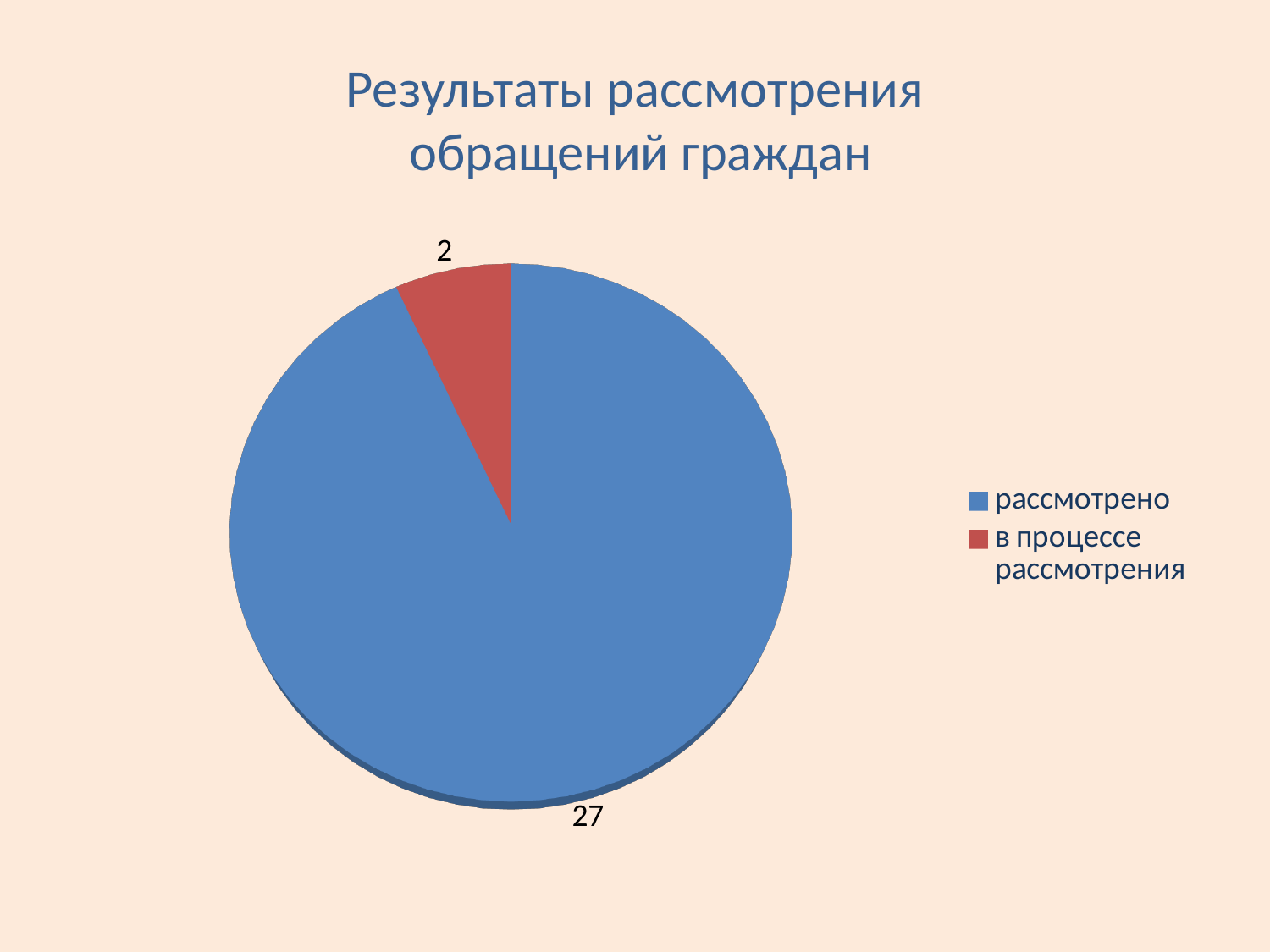
What value is shown for the 'в процессе рассмотрения' slice? 2 What is the title of the chart? Результаты рассмотрения обращений граждан Which category has the smallest slice of the pie? в процессе рассмотрения What is the difference between the 'рассмотрено' value and the 'в процессе рассмотрения' value? 25 What value is shown for the 'рассмотрено' slice? 27 What kind of chart is shown on the slide? pie chart Which is larger: the value for 'рассмотрено' or the value for 'в процессе рассмотрения'? рассмотрено What colour is the 'в процессе рассмотрения' slice? red What is the total of the two values shown on the pie chart? 29 How many slices does the pie chart have? 2 How many entries does the legend list? 2 Which category has the largest slice of the pie? рассмотрено